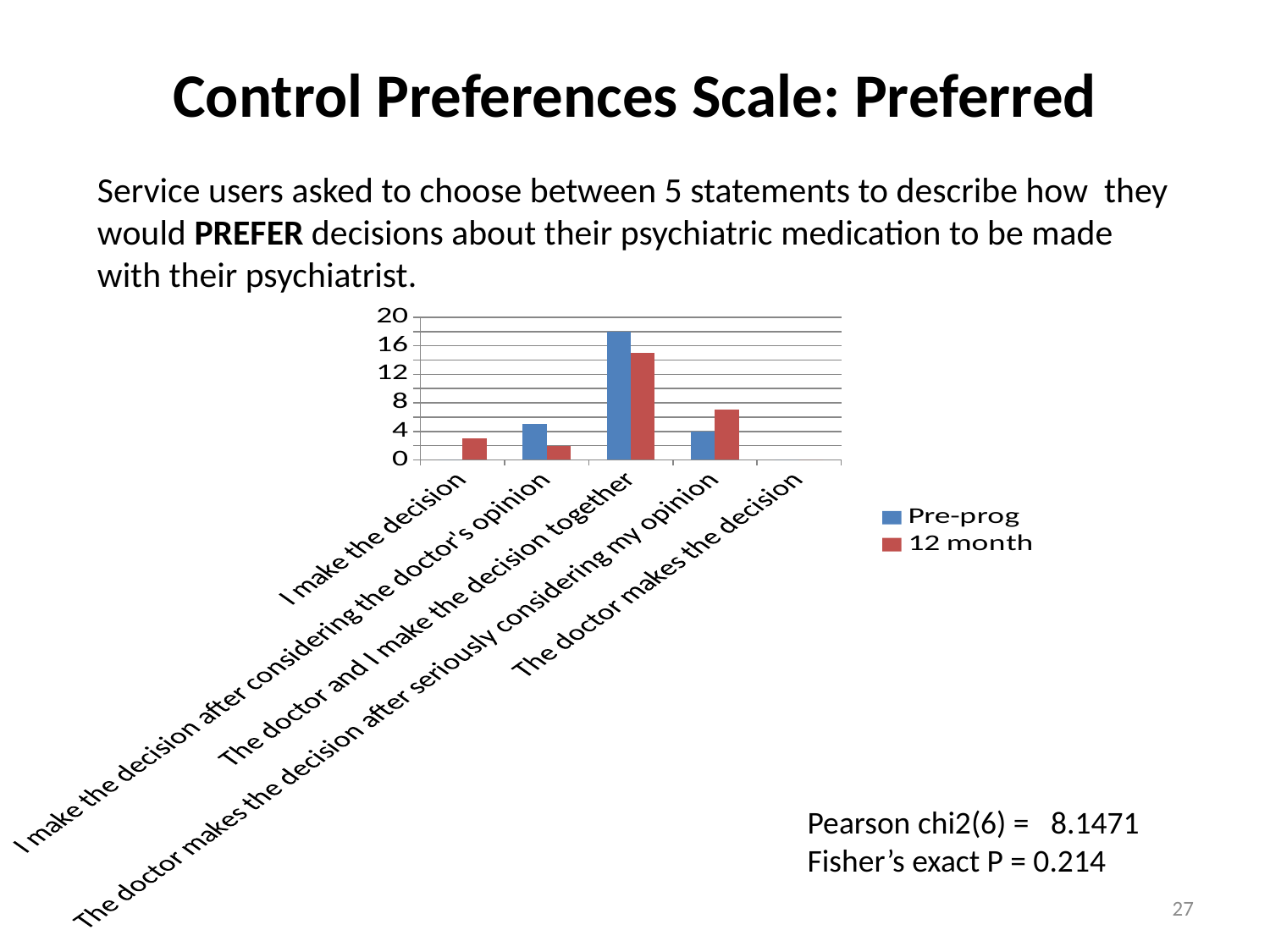
Which category has the highest 12 month value? The doctor and I make the decision together For 'I make the decision after considering the doctor's opinion', which is larger: Pre-prog or 12 month? Pre-prog Is the 12 month value for 'The doctor and I make the decision together' greater or less than 12? greater For 'The doctor makes the decision after seriously considering my opinion', which is larger: Pre-prog or 12 month? 12 month How many series does the chart's legend list? 2 What kind of chart is shown on the slide? bar chart What are the two series named in the chart's legend? Pre-prog and 12 month For 'The doctor and I make the decision together', which is larger: Pre-prog or 12 month? Pre-prog Which category has the highest Pre-prog value? The doctor and I make the decision together Is the 12 month value for 'The doctor makes the decision after seriously considering my opinion' greater or less than 4? greater Is the Pre-prog value for 'The doctor and I make the decision together' greater or less than 16? greater How many categories are shown along the x axis of the chart? 5